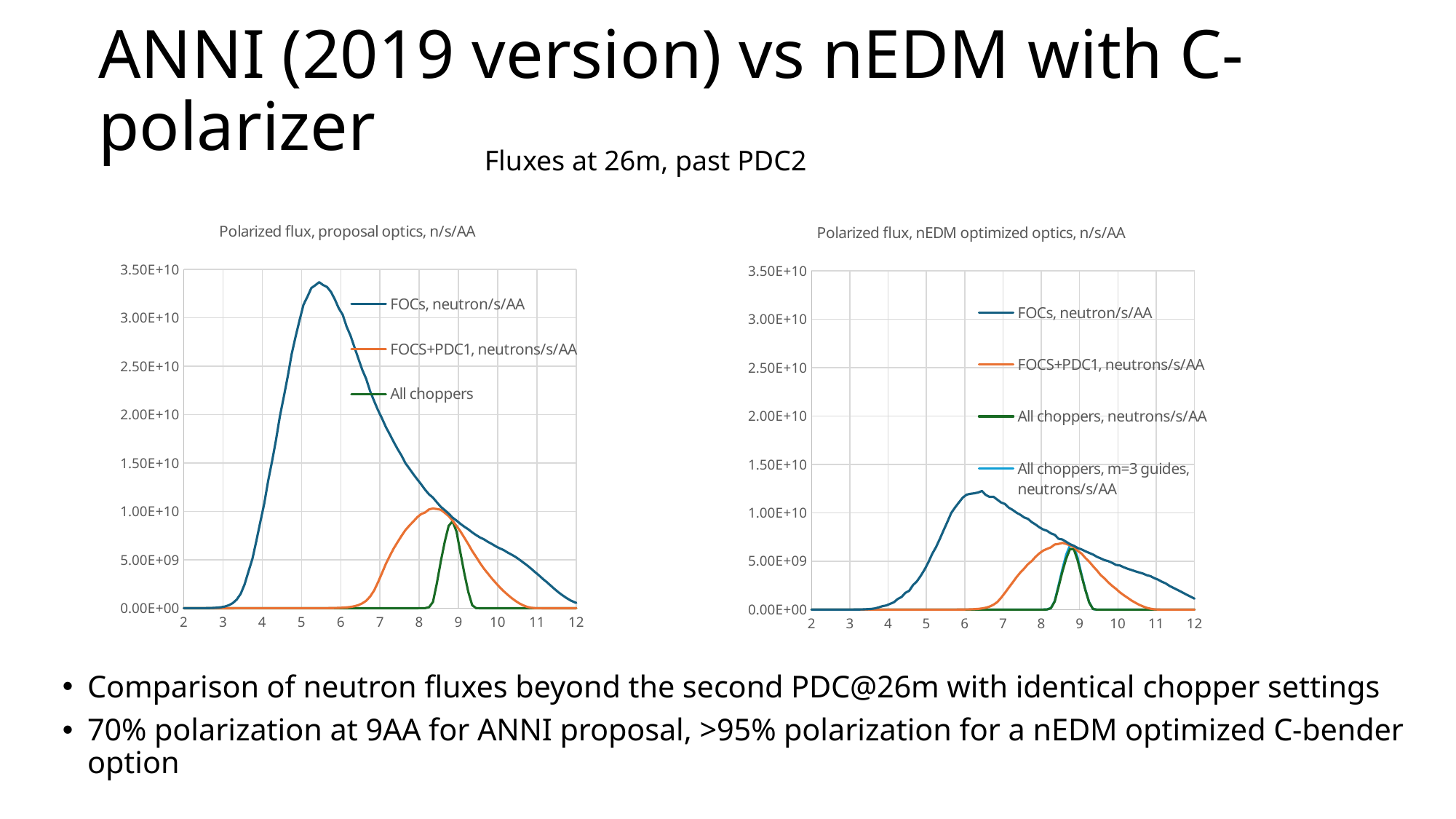
In the right chart ('Polarized flux, nEDM optimized optics'), which series reaches the highest peak value? FOCs, neutron/s/AA In the right chart ('Polarized flux, nEDM optimized optics'), is the peak value of the FOCS+PDC1 series greater or less than 1.00E+10? less How many series does the legend of the left chart ('Polarized flux, proposal optics, n/s/AA') list? 3 In the left chart ('Polarized flux, proposal optics'), which series reaches the highest peak value? FOCs, neutron/s/AA In the left chart ('Polarized flux, proposal optics'), is the peak value of the FOCs series greater or less than 3.00E+10? greater What is the title of the right chart? Polarized flux, nEDM optimized optics, n/s/AA In the right chart ('Polarized flux, nEDM optimized optics'), is the peak value of the FOCs series greater or less than 1.50E+10? less How many series does the legend of the right chart ('Polarized flux, nEDM optimized optics, n/s/AA') list? 4 Which chart has the higher peak for the FOCs series: the left chart (proposal optics) or the right chart (nEDM optimized optics)? the left chart (proposal optics) What type of chart is the left chart titled 'Polarized flux, proposal optics, n/s/AA'? line chart In the left chart ('Polarized flux, proposal optics'), does the FOCs series rise or fall between x = 6 and x = 12? fall In the right chart ('Polarized flux, nEDM optimized optics'), does the FOCs series rise or fall between x = 3 and x = 6? rise